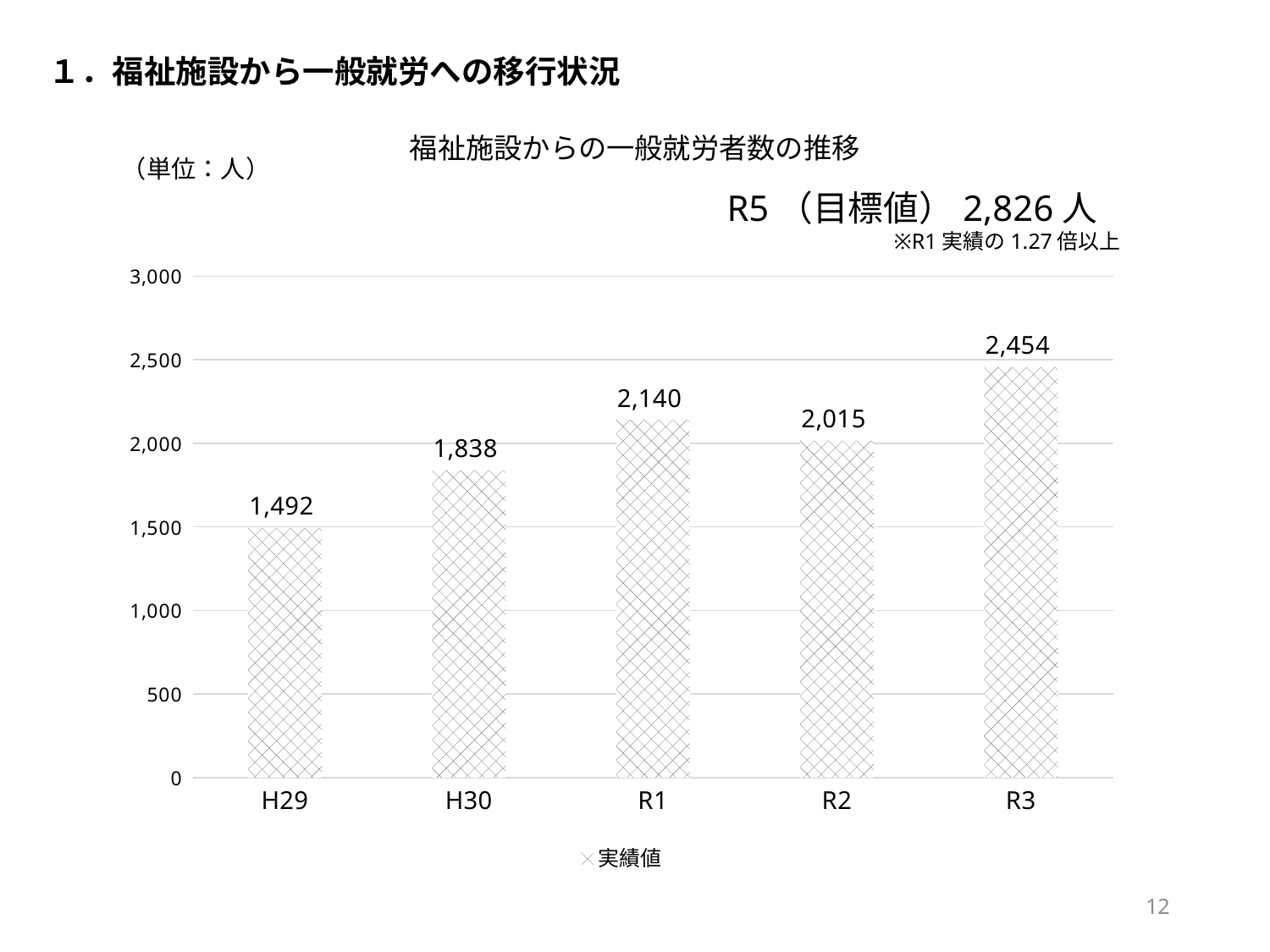
How many series does the legend list? 1 How many categories are shown on the x axis? 5 Which category has the lowest value? H29 Which category has the highest value? R3 What is the difference between the values for R1 and R2? 125 What is the value for H29? 1,492 What kind of chart is this? bar chart What is the title of the chart? 福祉施設からの一般就労者数の推移 Which is larger, the value for H30 or the value for R2? R2 What is the difference between the values for R3 and H29? 962 What is the value for R2? 2,015 What is the value for R1? 2,140